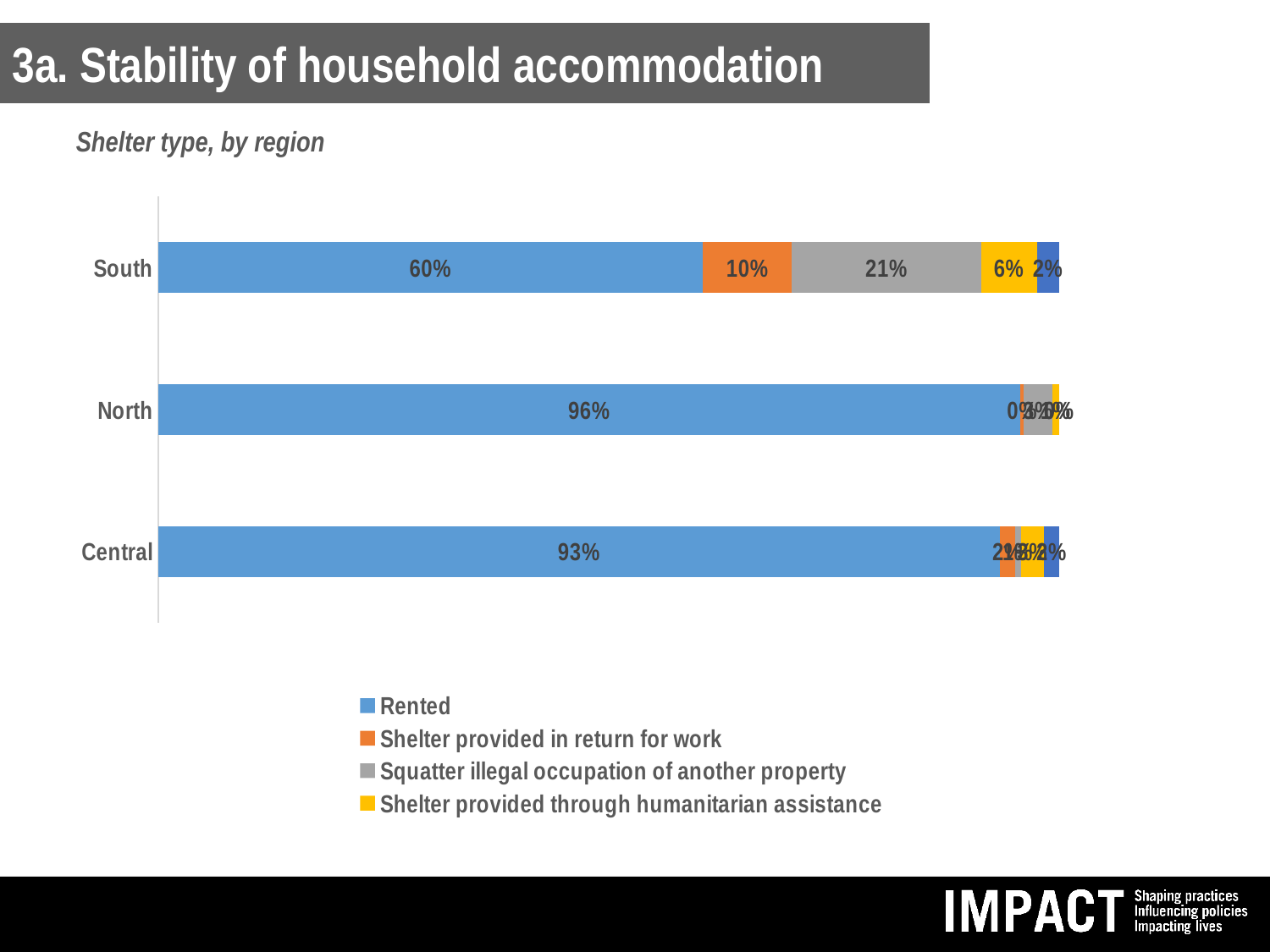
What is the value for 'Shelter provided in return for work' in the South region? 10% What is the value for 'Shelter provided through humanitarian assistance' in the South region? 6% How many percentage points higher is the rented share in the North than in the South? 36 percentage points Which region has the lowest share of rented shelter? South What percentage of households in the Central region live in rented shelter? 93% What percentage of households in the North region live in rented shelter? 96% How many regions are shown on the chart? 3 How many series does the legend list? 4 What share of South region households are in 'Squatter illegal occupation of another property'? 21% In the South region, which is larger: 'Squatter illegal occupation of another property' or 'Shelter provided in return for work'? Squatter illegal occupation of another property Which region has the highest share of rented shelter? North What percentage of households in the South region live in rented shelter? 60%